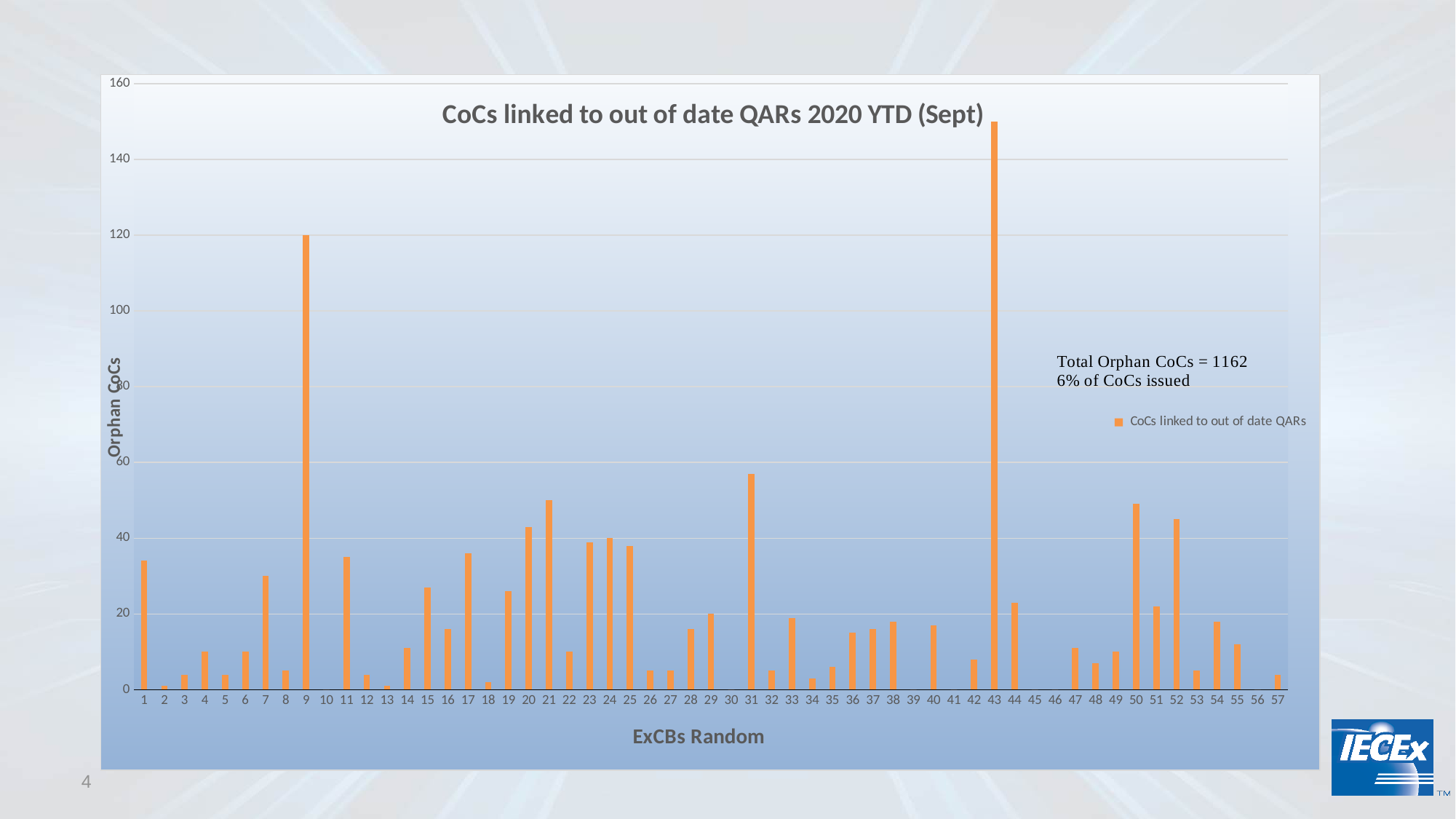
Which has the larger value, category 31 or category 21? 31 Which has the larger value, category 9 or category 43? 43 What is the value for category 9? 120 How many series does the legend list? 1 Which category has the highest value? 43 What is the x-axis title of the chart? ExCBs Random Is the value for category 44 greater or less than 40? less How many categories are shown on the x axis? 57 What is the title of the chart? CoCs linked to out of date QARs 2020 YTD (Sept) Is the value for category 31 greater or less than 40? greater What type of chart is shown on the slide? bar chart Is the value for category 43 greater or less than 140? greater